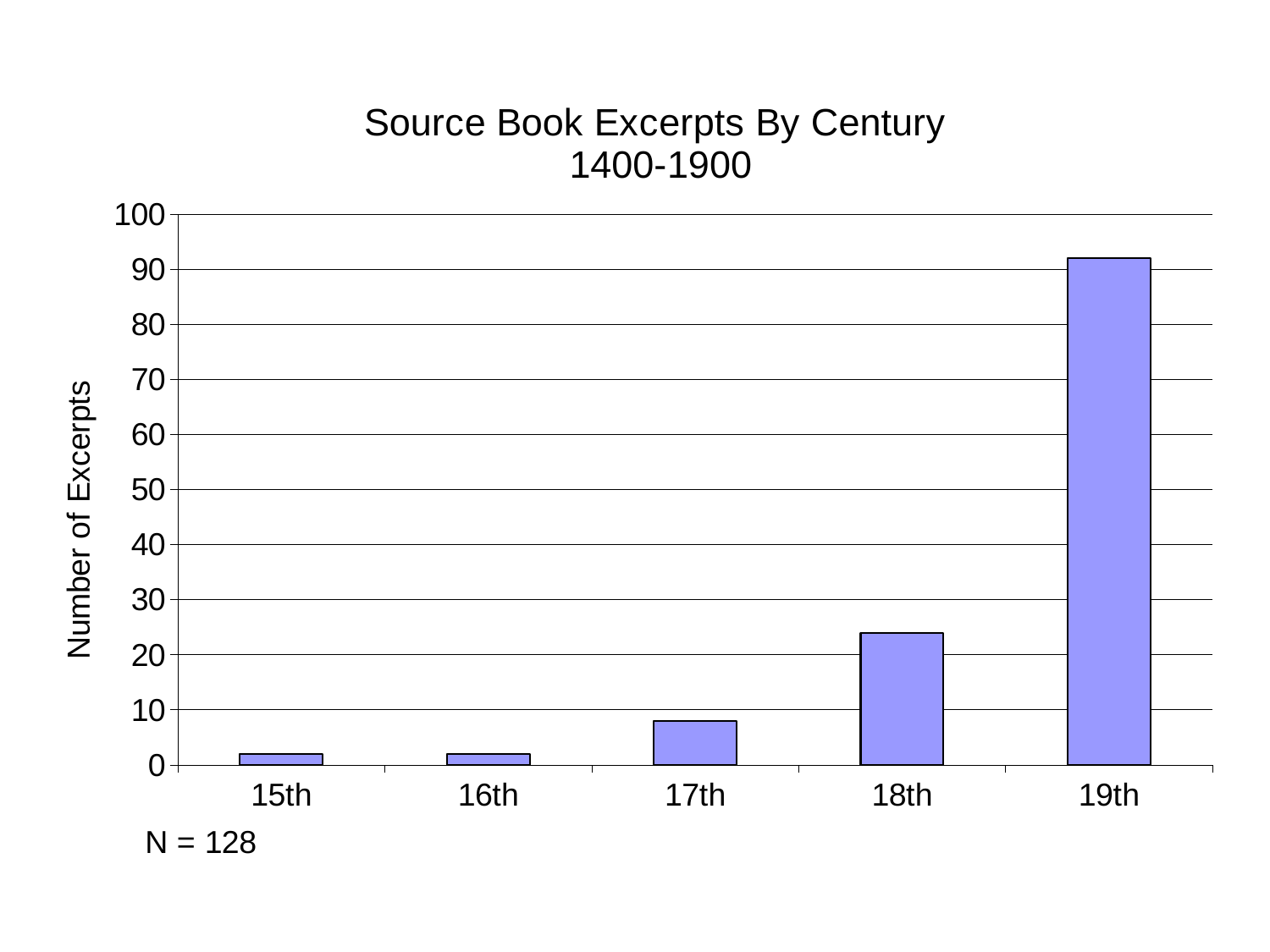
Is the value for the 18th century greater or less than 30? less What is the label on the y axis? Number of Excerpts Do the values generally rise or fall from the 15th century to the 19th century? rise How many centuries are shown on the x axis? 5 Which century has the highest number of excerpts? 19th Is the value for the 18th century greater or less than 20? greater Which has more excerpts, the 19th century or the 18th century? 19th What is the title of the chart? Source Book Excerpts By Century 1400-1900 Is the value for the 19th century greater or less than 80? greater Which has more excerpts, the 18th century or the 17th century? 18th What kind of chart is shown on the slide? bar chart